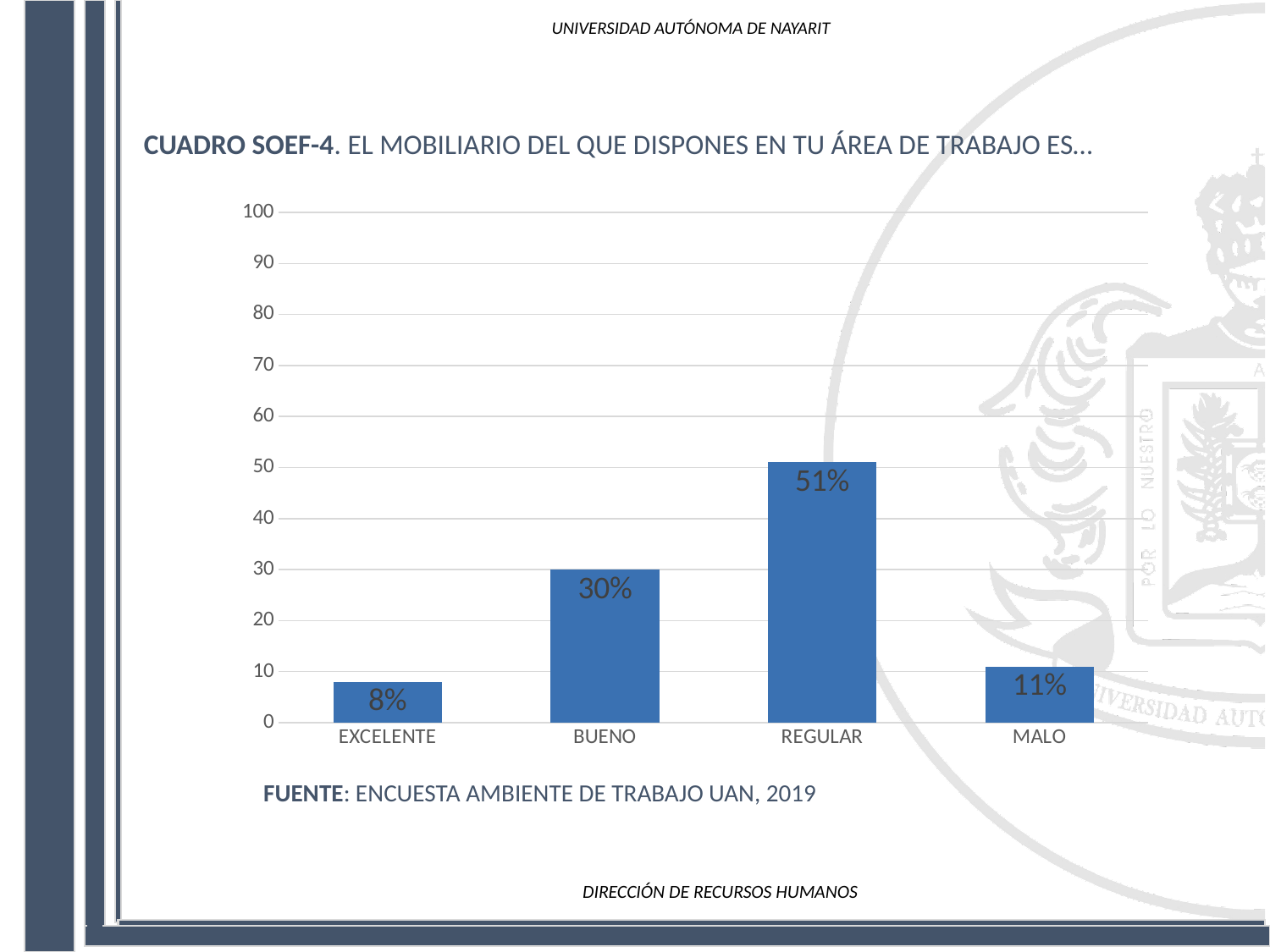
What source is cited below the chart? ENCUESTA AMBIENTE DE TRABAJO UAN, 2019 What is the value for REGULAR? 51% What is the difference between the values for REGULAR and BUENO? 21% Which is larger, the value for MALO or the value for EXCELENTE? MALO What is the value for MALO? 11% Is the value for BUENO greater or less than 40? less What kind of chart is shown on the slide? bar chart How many categories are shown on the x axis? 4 Which category has the lowest value? EXCELENTE Which category has the highest value? REGULAR What is the value for BUENO? 30% What is the value for EXCELENTE? 8%